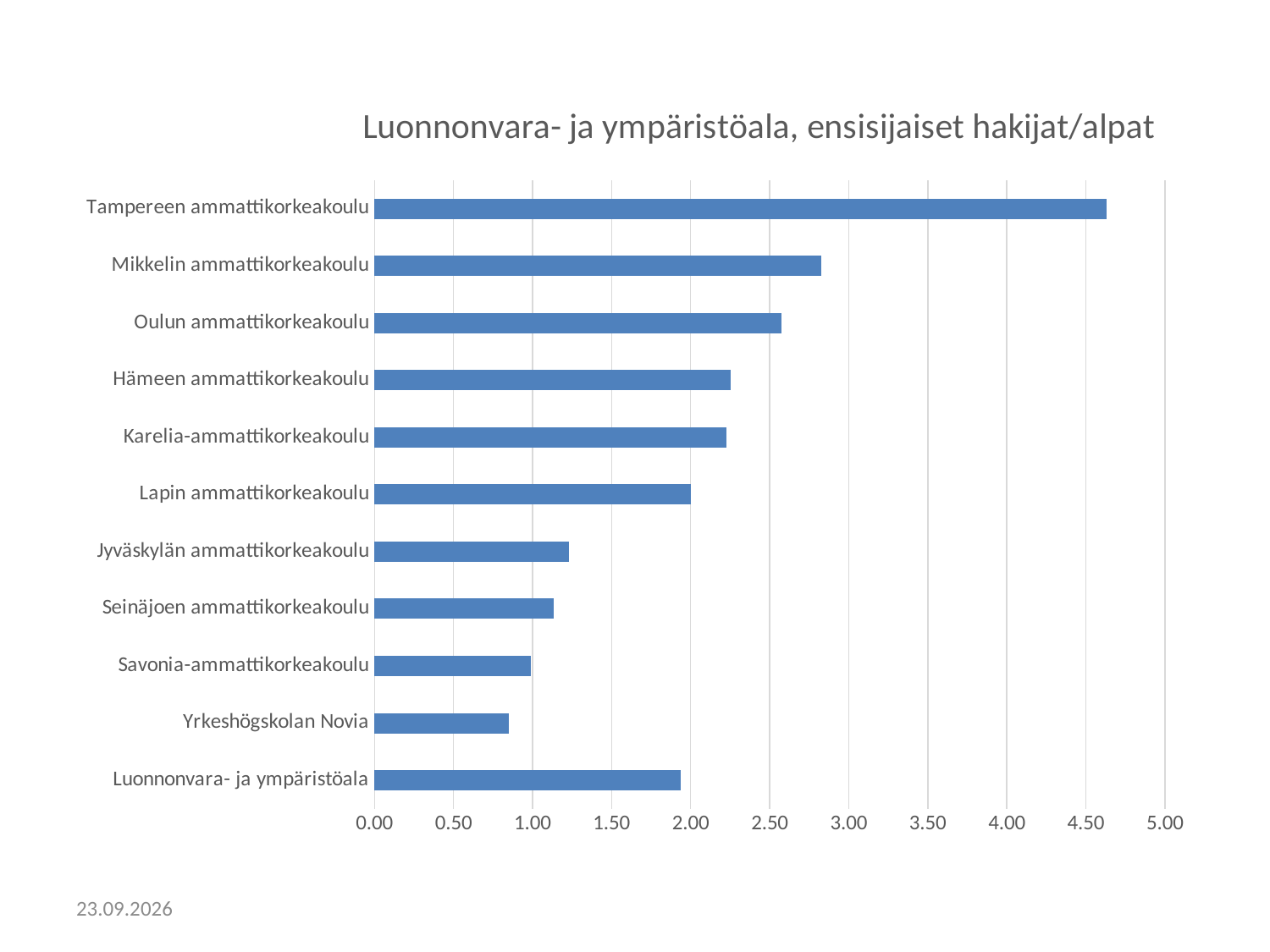
Which has a larger value, Tampereen ammattikorkeakoulu or Mikkelin ammattikorkeakoulu? Tampereen ammattikorkeakoulu How many categories (bars) are shown in the chart? 11 Is the value for Hämeen ammattikorkeakoulu greater or less than 2.50? less Which category has the lowest value? Yrkeshögskolan Novia Is the value for Seinäjoen ammattikorkeakoulu greater or less than 1.00? greater Is the value for Yrkeshögskolan Novia greater or less than 1.00? less Which category has the highest value? Tampereen ammattikorkeakoulu What kind of chart is shown on the slide? bar chart What is the title of the chart? Luonnonvara- ja ympäristöala, ensisijaiset hakijat/alpat Which has a larger value, Oulun ammattikorkeakoulu or Hämeen ammattikorkeakoulu? Oulun ammattikorkeakoulu